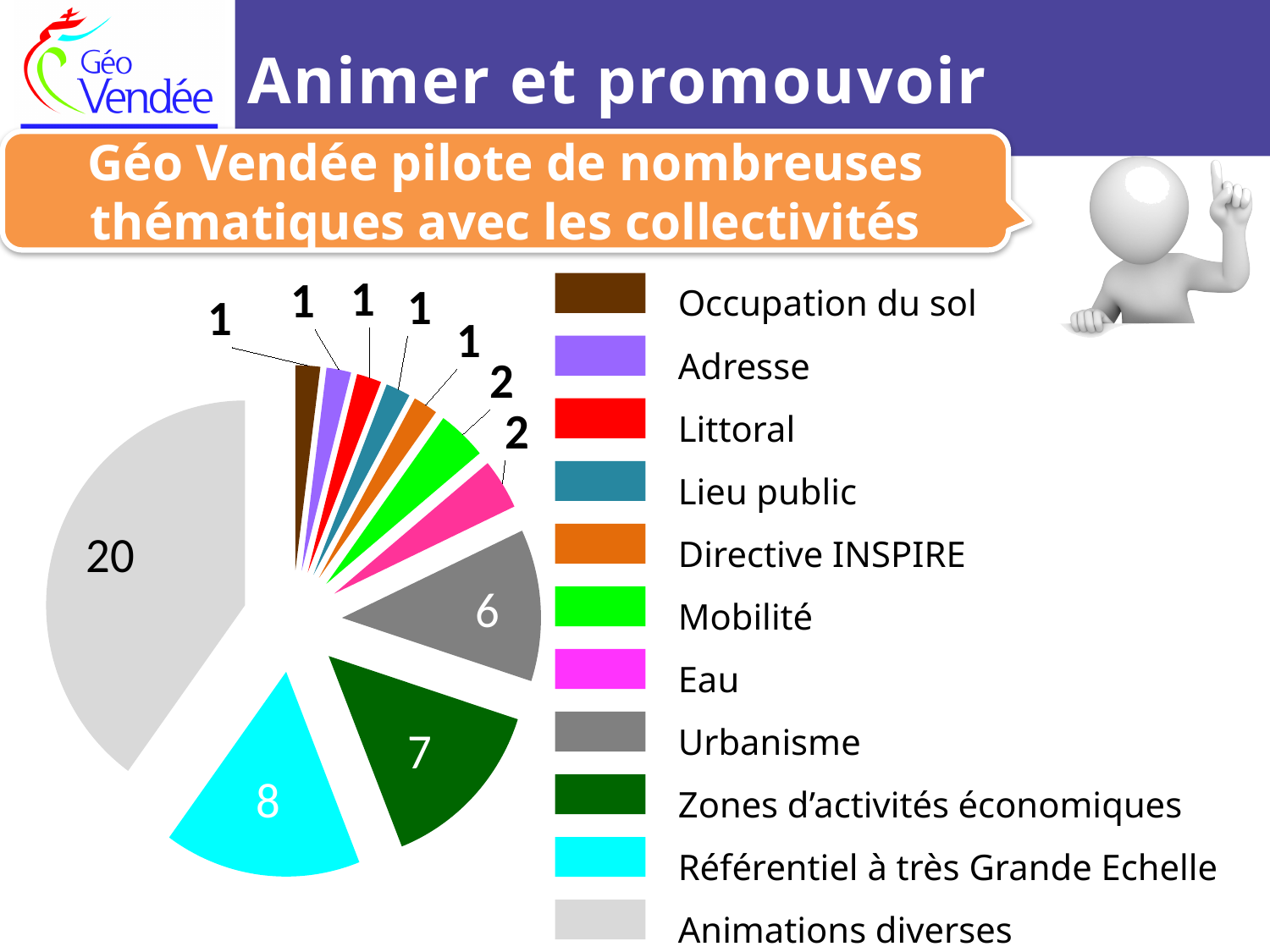
What is the value of the Urbanisme slice? 6 What is the value of the Zones d'activités économiques slice? 7 What kind of chart is shown on the slide? pie chart What is the difference between the Animations diverses value and the Référentiel à très Grande Echelle value? 12 What is the value of the Animations diverses slice? 20 What is the value of the Référentiel à très Grande Echelle slice? 8 What colour is the Eau slice in the pie chart? pink What share of the pie does the Animations diverses slice represent? 40% What is the total of all the slice values in the pie chart? 50 Which category has the largest slice of the pie? Animations diverses How many categories does the pie chart's legend list? 11 Which is larger, the Urbanisme slice or the Zones d'activités économiques slice? Zones d'activités économiques